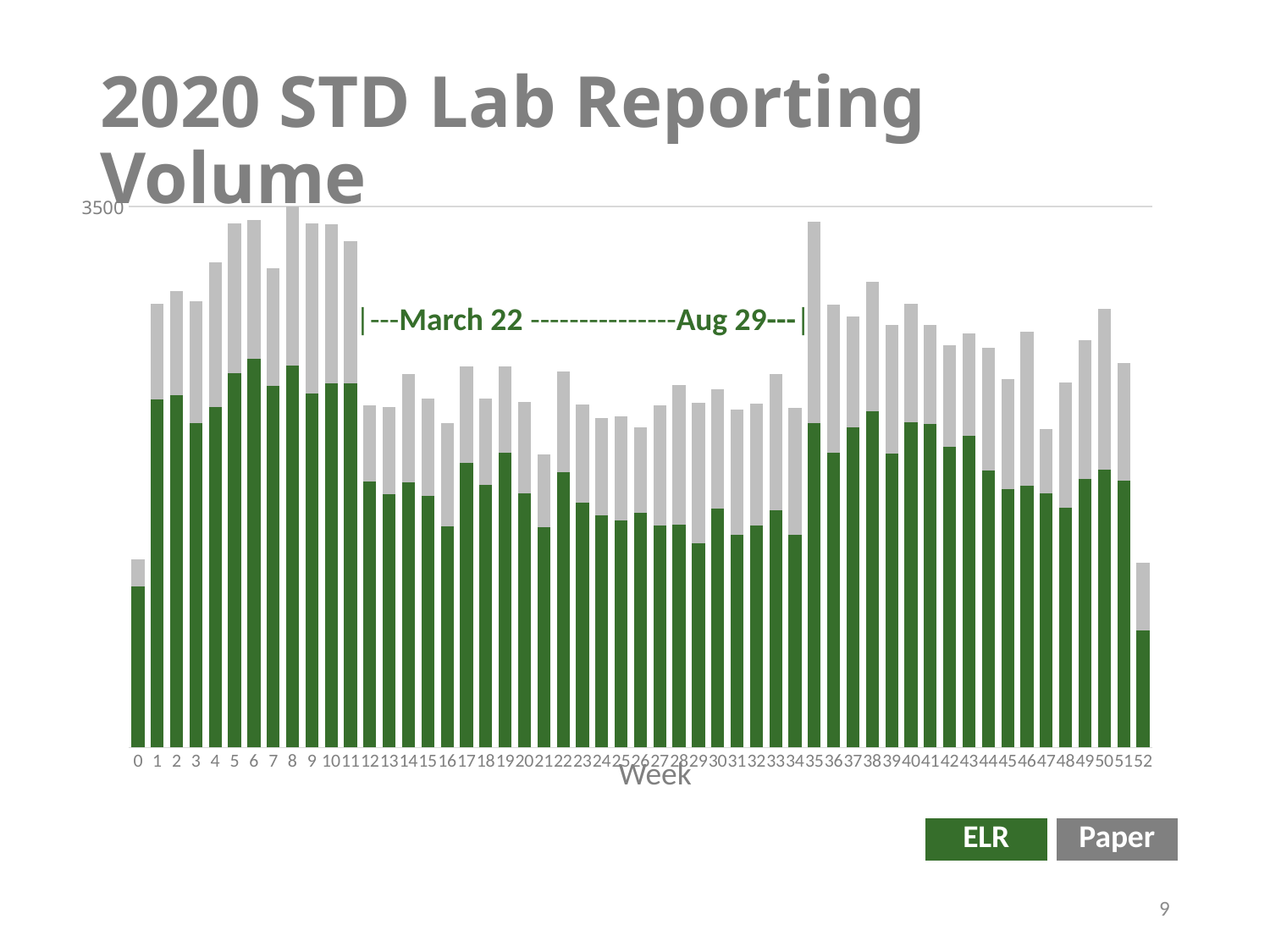
Which week has the highest total reporting volume? Week 8 Which has the larger ELR volume, week 16 or week 17? Week 17 What kind of chart is shown on the slide? Stacked bar chart What are the two series named in the legend? ELR and Paper What is the label of the x axis? Week Is the total volume for week 35 greater or less than 3500? less Which has the larger total volume, week 35 or week 36? Week 35 Do the total volumes rise or fall from week 0 to week 8? rise Is the total volume for week 0 greater or less than 3500? less How many weeks are plotted along the x axis? 53 How many series does the legend list? 2 Which week has the lowest ELR volume? Week 52